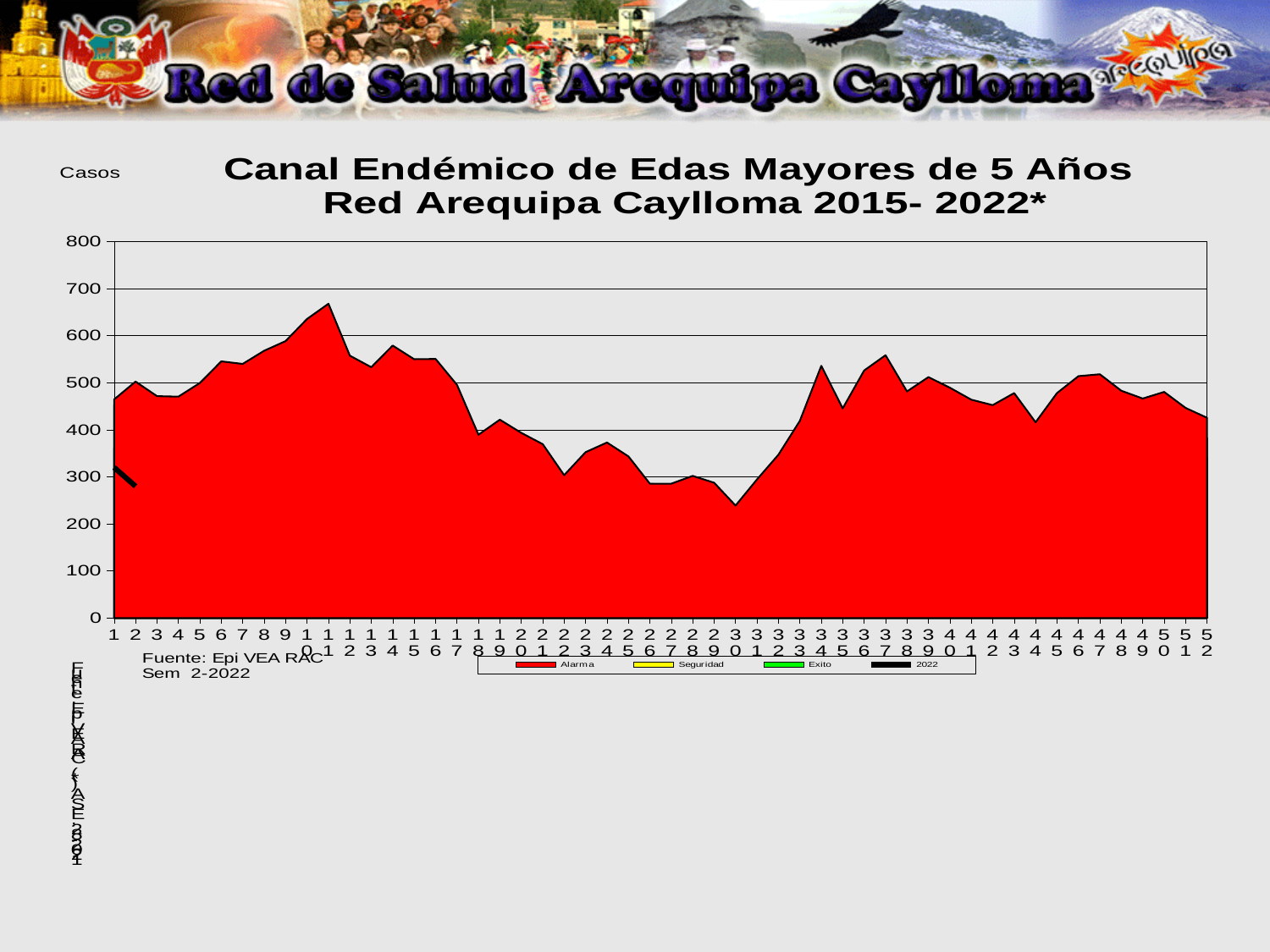
Is the Alarma value for week 1 greater or less than 400? greater Do the Alarma values rise or fall from week 11 to week 30? Fall Is the Alarma value for week 30 greater or less than 300? less What kind of chart is shown on the slide? Area chart Which week has the larger Alarma value, week 11 or week 34? Week 11 Is the Alarma value for week 34 greater or less than 500? greater At which week does the Alarma area reach its lowest value? Week 30 How many series does the legend list? 4 At which week does the Alarma area reach its highest value? Week 11 What is the title of the chart? Canal Endémico de Edas Mayores de 5 Años Red Arequipa Caylloma 2015- 2022* How many weeks (points) are plotted along the x axis? 52